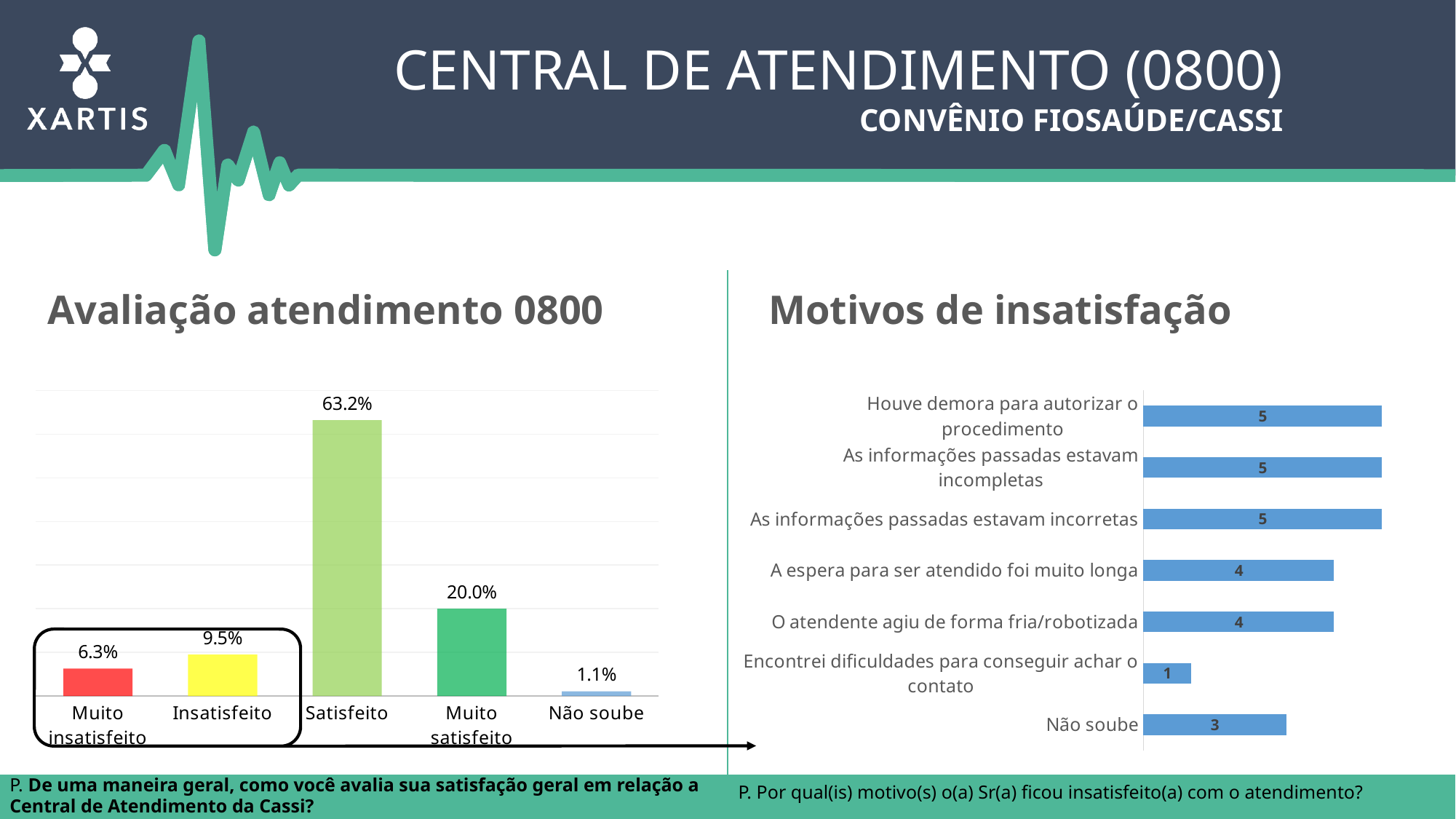
In the 'Motivos de insatisfação' chart, what is the value for 'A espera para ser atendido foi muito longa'? 4 In the 'Avaliação atendimento 0800' chart, what is the value for Muito insatisfeito? 6.3% In the 'Avaliação atendimento 0800' chart, which category has the lowest value? Não soube What kind of chart is 'Motivos de insatisfação'? Bar chart In the 'Motivos de insatisfação' chart, which category has the lowest value? Encontrei dificuldades para conseguir achar o contato In the 'Avaliação atendimento 0800' chart, what is the value for Satisfeito? 63.2% In the 'Avaliação atendimento 0800' chart, which is larger: Insatisfeito or Muito insatisfeito? Insatisfeito In the 'Avaliação atendimento 0800' chart, what is the difference between Muito satisfeito and Insatisfeito? 10.5% In the 'Avaliação atendimento 0800' chart, which category has the highest value? Satisfeito How many categories are shown in the 'Motivos de insatisfação' chart? 7 How many categories are shown in the 'Avaliação atendimento 0800' chart? 5 In the 'Motivos de insatisfação' chart, what is the difference between 'Não soube' and 'Encontrei dificuldades para conseguir achar o contato'? 2